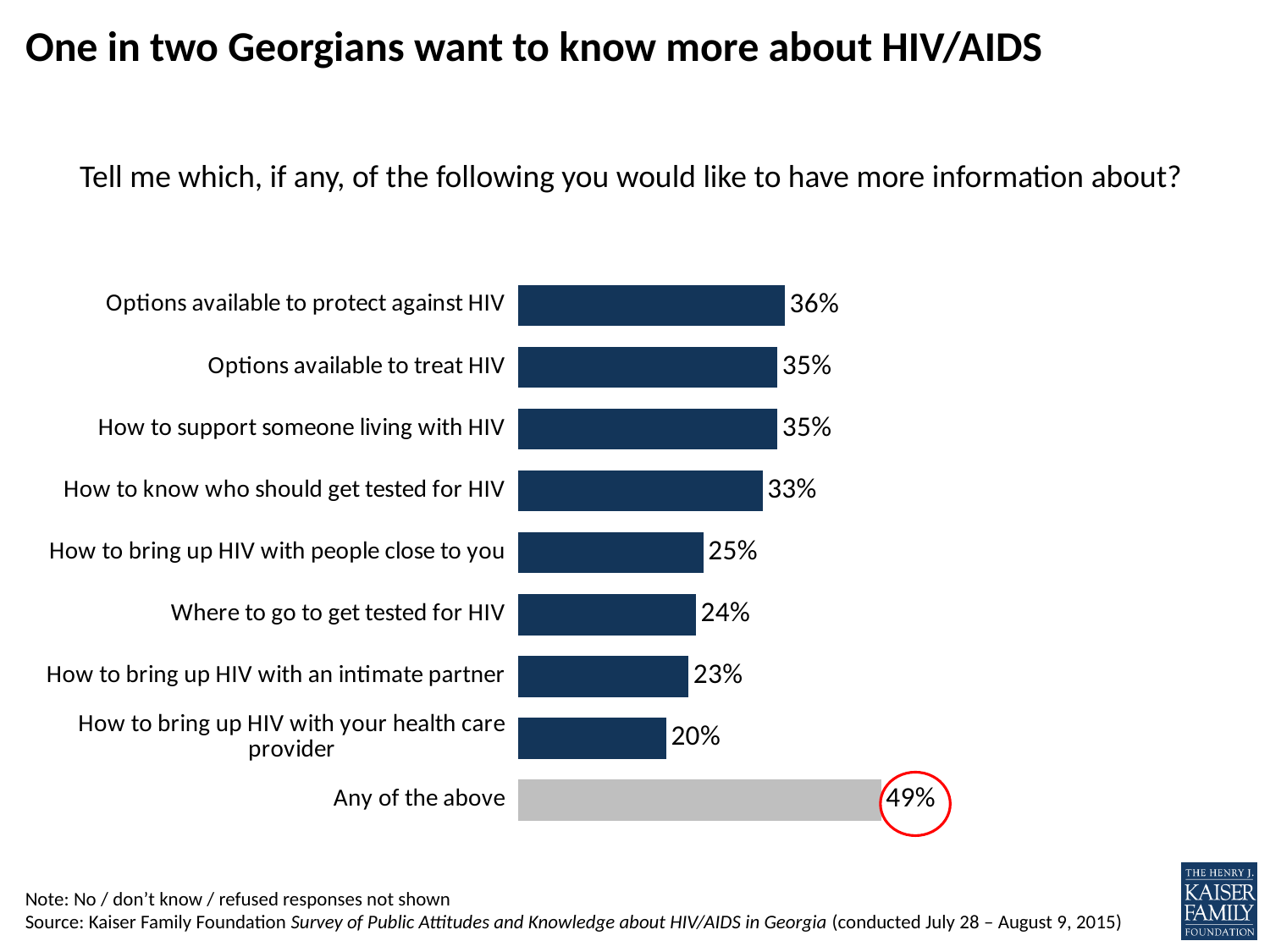
How many categories are shown on the chart? 9 Which category has the lowest value on the chart? How to bring up HIV with your health care provider Which value on the chart is circled in red? 49% What is the value for 'Where to go to get tested for HIV'? 24% What percentage of Georgians would like more information about options available to protect against HIV? 36% Which is larger: the value for 'How to know who should get tested for HIV' or the value for 'How to bring up HIV with people close to you'? How to know who should get tested for HIV What kind of chart is shown on the slide? Bar chart What is the difference between the values for 'Options available to protect against HIV' and 'How to bring up HIV with your health care provider'? 16% What is the value for 'Any of the above'? 49% Which bar is shown in a different colour (grey) from the others? Any of the above What is the value for 'How to bring up HIV with your health care provider'? 20% Which category has the highest value on the chart? Any of the above